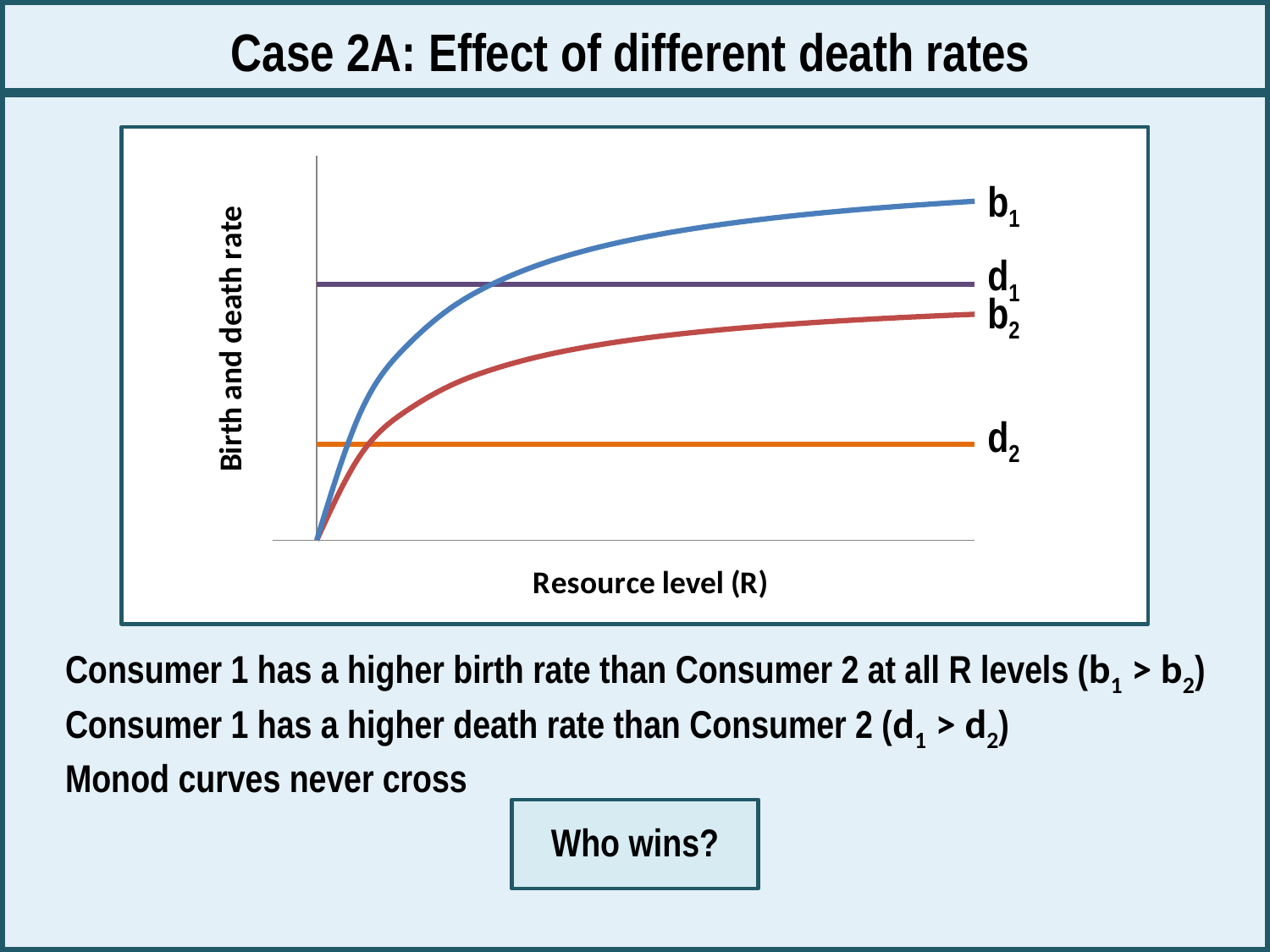
Which is higher on the chart: d1 or d2? d1 What is the label of the x axis of the chart? Resource level (R) Does the b1 curve rise or fall as resource level (R) increases? Rises What kind of chart is shown on the slide? Line chart At high resource levels, which is larger: b1 or b2? b1 Which line is lowest on the chart at high resource levels? d2 What is the label of the y axis of the chart? Birth and death rate Which two curves on the chart are horizontal lines? d1 and d2 Which curve reaches the highest birth and death rate at the right end of the chart? b1 Does the d2 line rise, fall, or stay flat as resource level (R) increases? Stays flat How many curves are plotted on the chart? 4 At high resource levels, which is larger: b2 or d1? d1